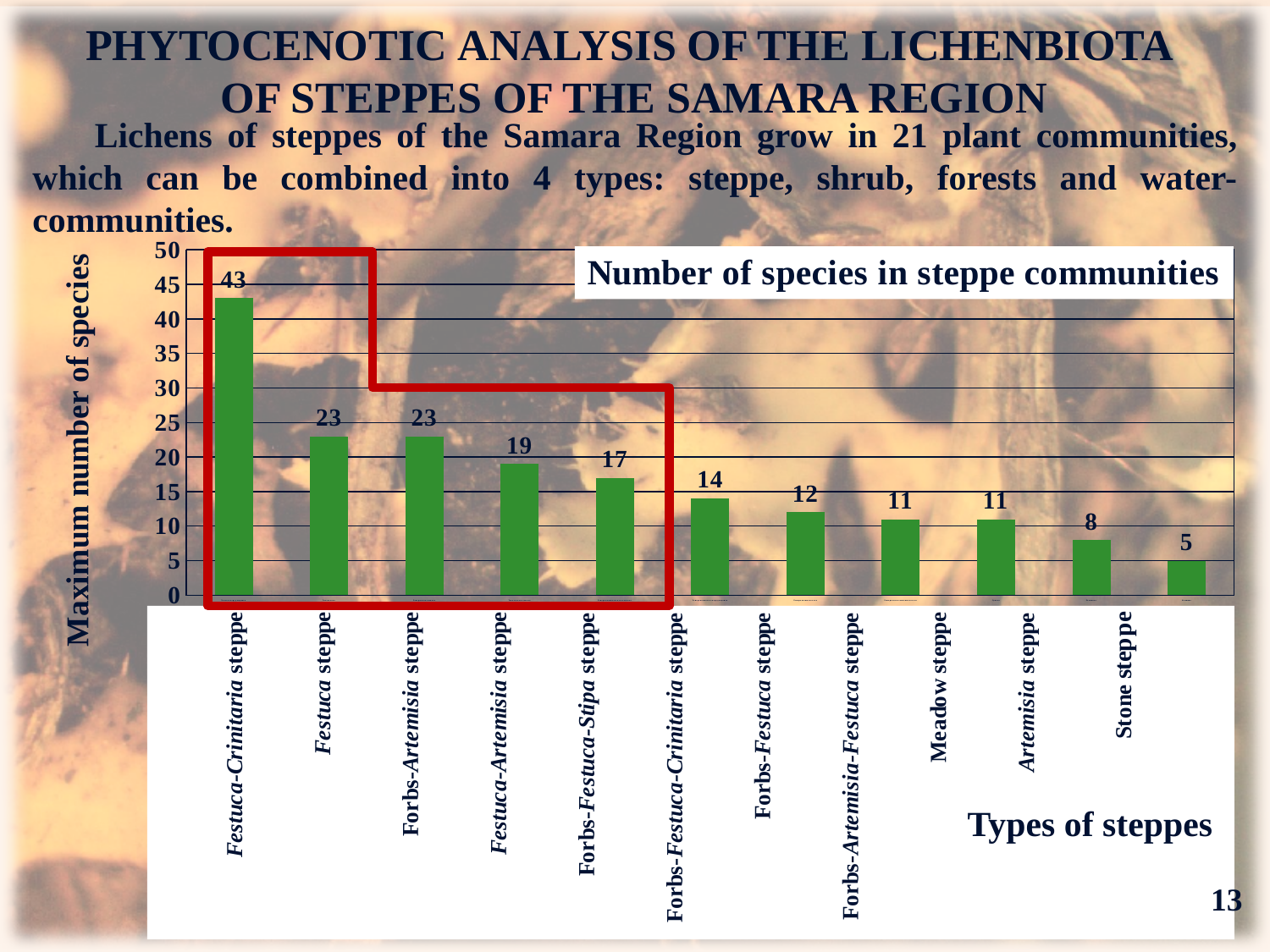
How many types of steppes are shown on the chart? 11 Is the value for Festuca-Artemisia steppe greater or less than 15? greater What is the difference between the values for Festuca-Crinitaria steppe and Festuca steppe? 20 What is the title of the chart? Number of species in steppe communities Which type of steppe has the highest number of species? Festuca-Crinitaria steppe What kind of chart is shown on the slide? bar chart What is the value for Meadow steppe? 11 Which is larger, the value for Forbs-Festuca-Crinitaria steppe or the value for Artemisia steppe? Forbs-Festuca-Crinitaria steppe Do the values rise or fall from left to right along the x axis? fall What is the value for Forbs-Festuca-Stipa steppe? 17 Which type of steppe has the lowest number of species? Stone steppe What is the value for Festuca-Crinitaria steppe? 43